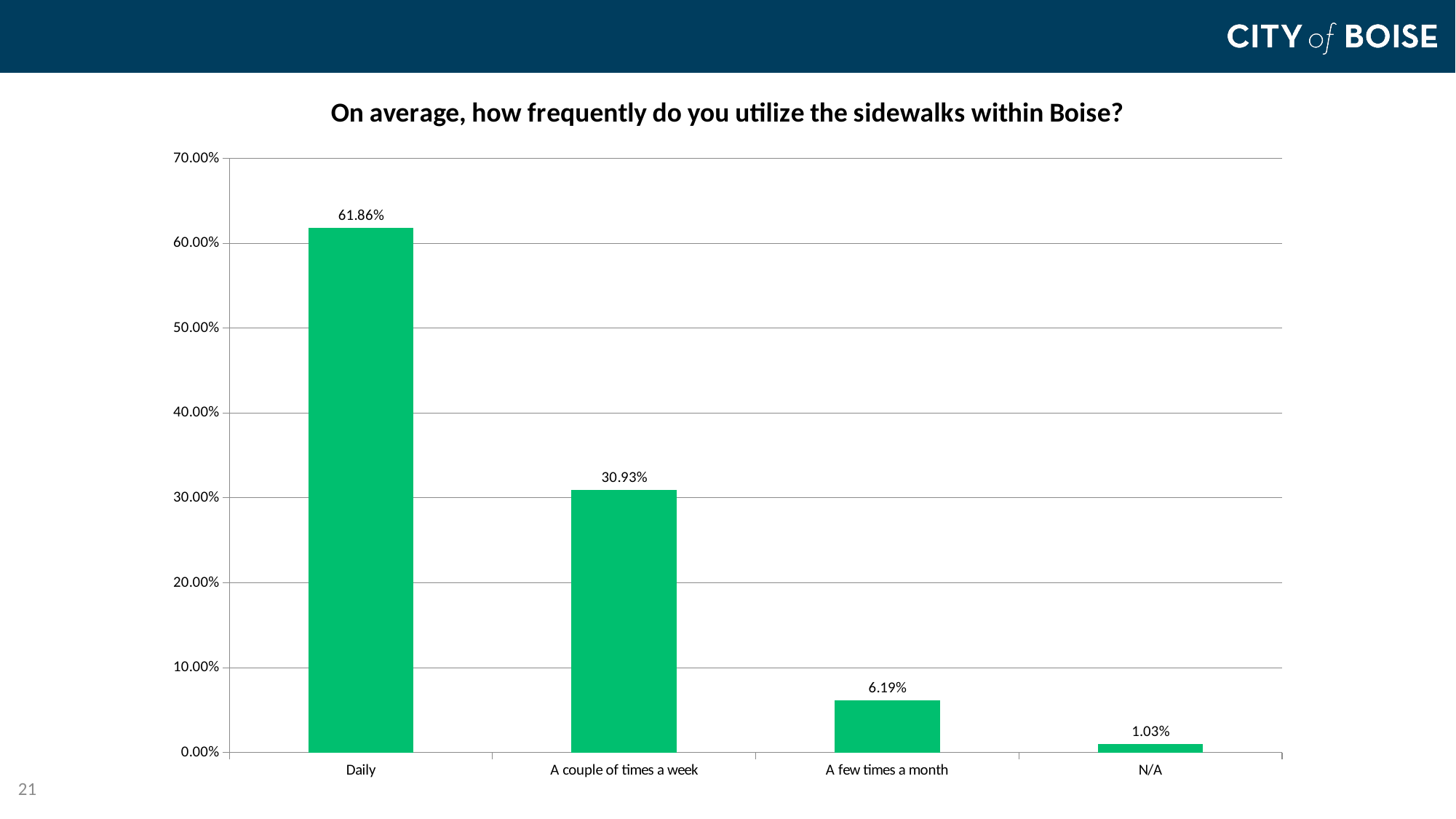
What kind of chart is shown on the slide? Bar chart What is the title of the chart? On average, how frequently do you utilize the sidewalks within Boise? What percentage of respondents said they use the sidewalks within Boise daily? 61.86% What is the value for 'A few times a month'? 6.19% Which category has the highest value? Daily How many categories are shown on the x axis? 4 Which is larger, the value for 'A few times a month' or the value for N/A? A few times a month What is the value for the N/A category? 1.03% Which category has the lowest value? N/A What is the value for 'A couple of times a week'? 30.93% What is the difference between the Daily value and the 'A couple of times a week' value? 30.93% Is the value for Daily greater or less than 60.00%? greater